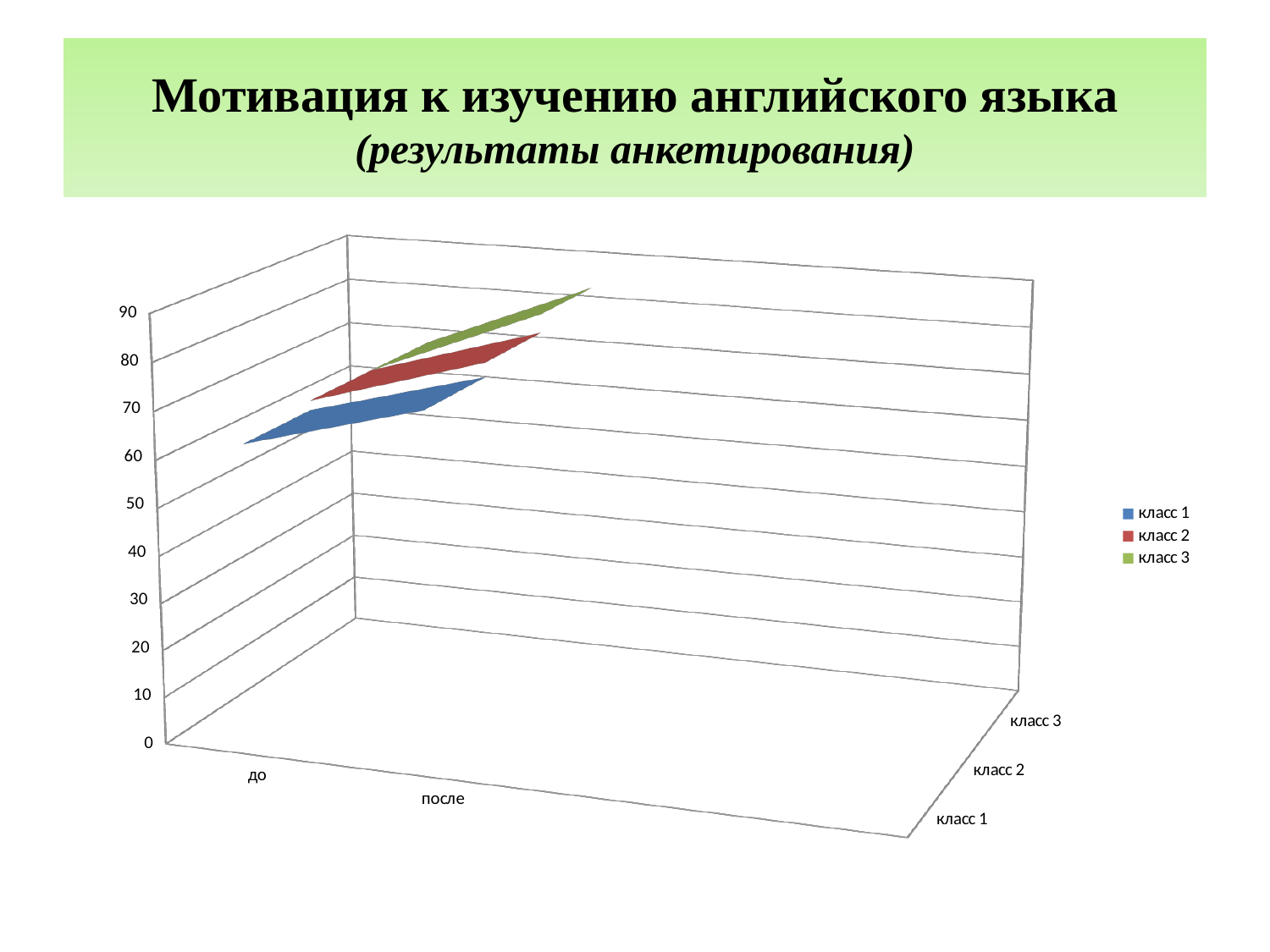
How many series does the legend list? 3 Is the value for класс 1 at до greater or less than 30? greater Which series are listed in the legend? класс 1, класс 2, класс 3 What is the maximum value shown on the vertical axis? 90 What kind of chart is shown on the slide? 3D line chart What are the two categories on the x axis? до, после How many categories are shown along the x axis? 2 Do the values for класс 2 rise or fall from до to после? rise Do the values for класс 1 rise or fall from до to после? rise Do the values for класс 3 rise or fall from до to после? rise